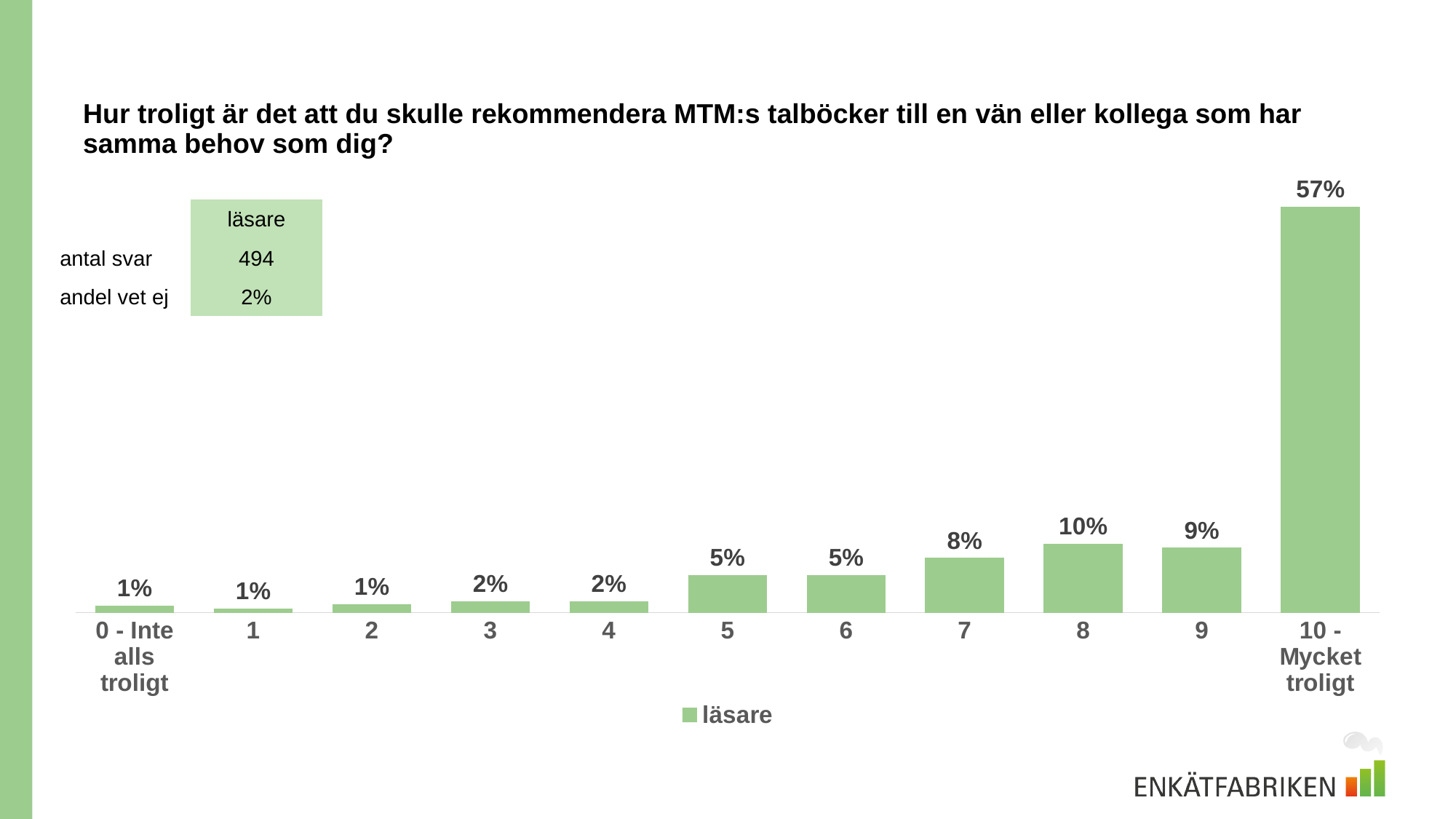
Which category has the highest value? 10 - Mycket troligt What is the value for category 5? 5% What is the value for the category "0 - Inte alls troligt"? 1% What is the difference between the values for category 9 and category 7? 1% What kind of chart is shown on the slide? bar chart How many series does the legend list? 1 Which is larger, the value for category 3 or the value for category 7? 7 How many categories are shown on the x axis? 11 Which is larger, the value for category 8 or the value for category 9? 8 What is the value for category 8? 10% What is the difference between the values for category 10 - Mycket troligt and category 8? 47% What is the value for the category "10 - Mycket troligt"? 57%